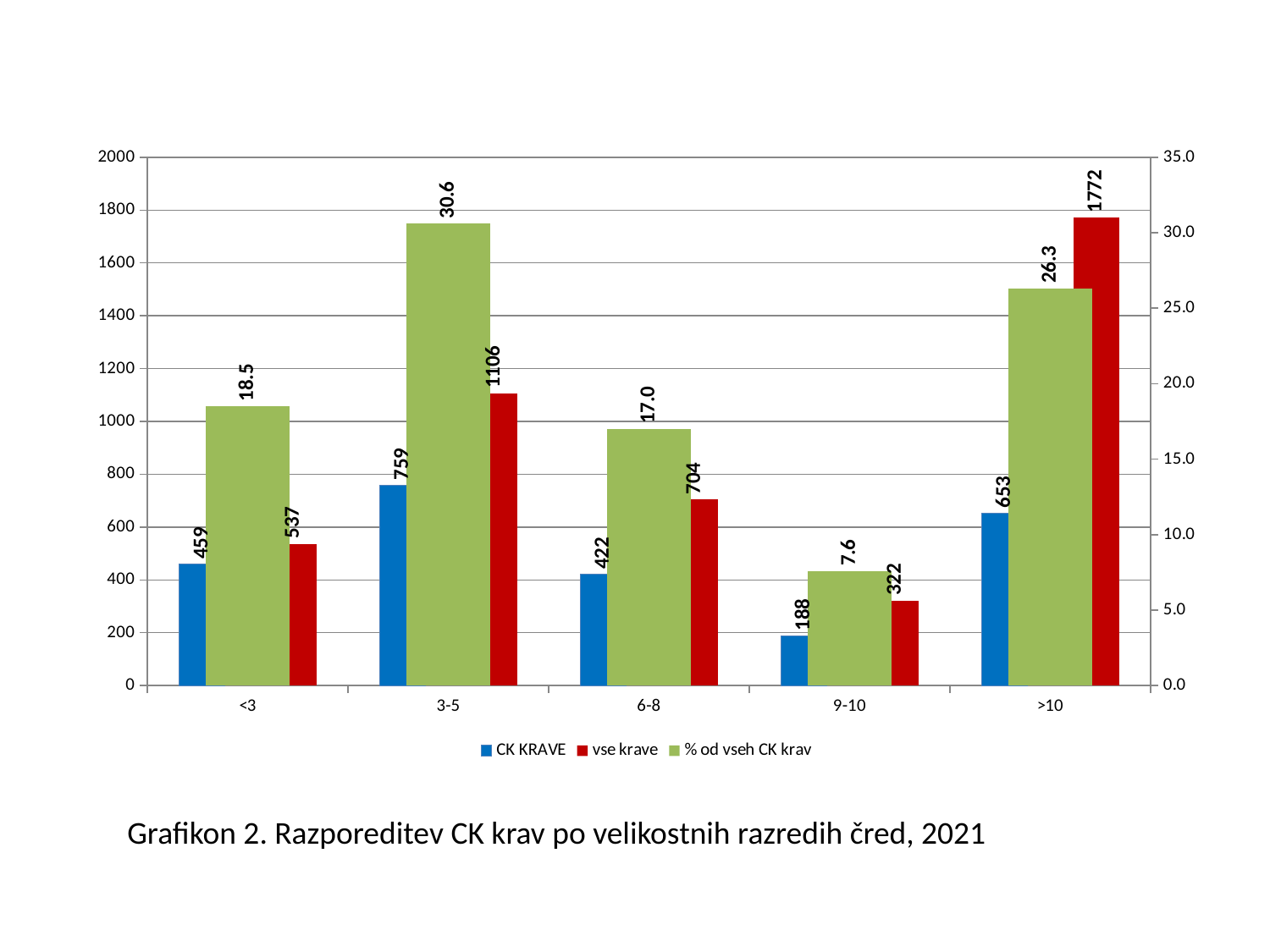
How many series does the legend list? 3 What is the difference between vse krave and CK KRAVE for the 6-8 category? 282 What is the value of vse krave for the >10 category? 1772 Which category has the lowest value for CK KRAVE? 9-10 What is the value of CK KRAVE for the 3-5 category? 759 What kind of chart is shown on the slide? bar chart Which category has the highest value for % od vseh CK krav? 3-5 How many categories are shown on the x axis? 5 What is the value of % od vseh CK krav for the 9-10 category? 7.6 Which is larger: CK KRAVE for <3 or CK KRAVE for >10? CK KRAVE for >10 What is the caption of the chart? Grafikon 2. Razporeditev CK krav po velikostnih razredih čred, 2021 Which category has the highest value for vse krave? >10